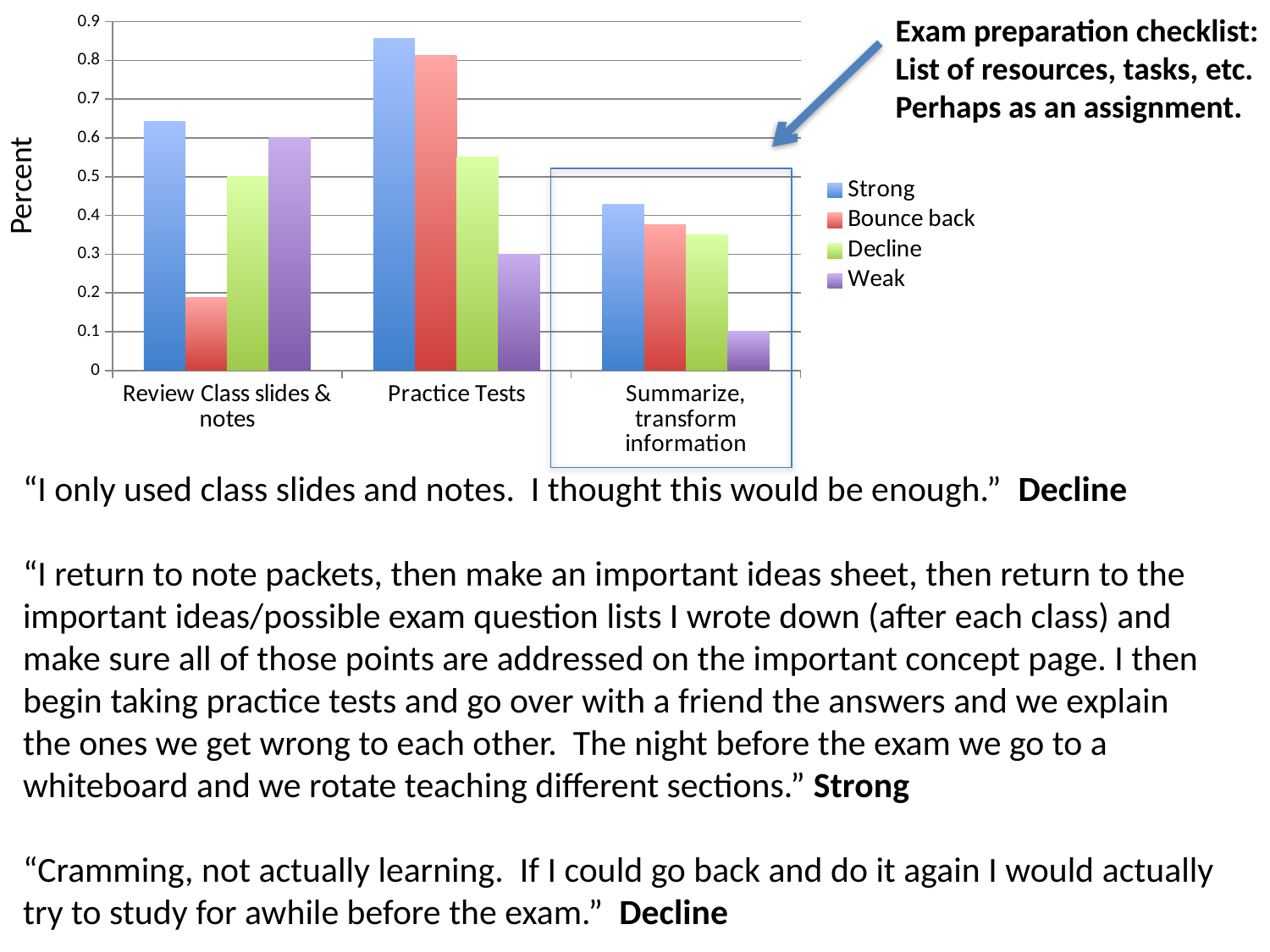
What kind of chart is shown on the slide? bar chart For Review Class slides & notes, which is larger: Strong or Bounce back? Strong How many series does the legend list? 4 Is the Bounce back value for Review Class slides & notes greater or less than 0.3? less For Practice Tests, which is larger: Decline or Weak? Decline What is the label on the y axis? Percent Which category has the highest value for the Strong series? Practice Tests How many categories are shown on the x axis? 3 Is the Weak value for Summarize, transform information greater or less than 0.2? less Is the Strong value for Practice Tests greater or less than 0.8? greater Which category has the lowest value for the Weak series? Summarize, transform information Within the Practice Tests category, which series has the lowest value? Weak